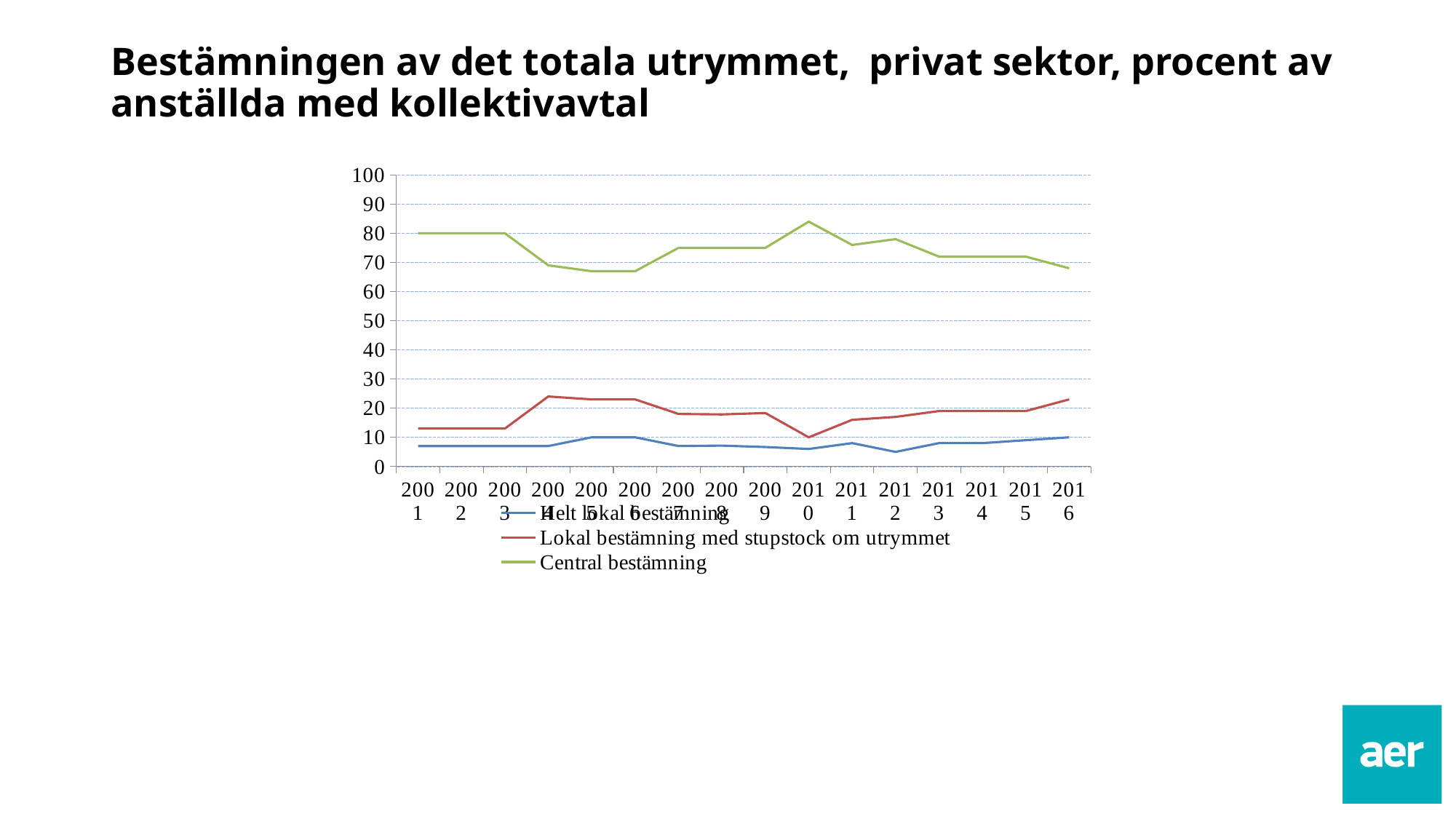
Is the value for Lokal bestämning med stupstock om utrymmet in 2004 greater or less than 20? greater What is the value for Central bestämning in 2001? 80 What kind of chart is shown on the slide? line chart In which year is Helt lokal bestämning at its lowest? 2012 Is the value for Central bestämning in 2016 greater or less than 70? less What is the value for Helt lokal bestämning in 2005? 10 How many series does the legend list? 3 In 2016, which is larger: Lokal bestämning med stupstock om utrymmet or Helt lokal bestämning? Lokal bestämning med stupstock om utrymmet Does Central bestämning rise or fall from 2012 to 2016? fall How many years are shown along the x axis? 16 In which year is Central bestämning at its highest? 2010 Is the value for Central bestämning in 2010 greater or less than 80? greater